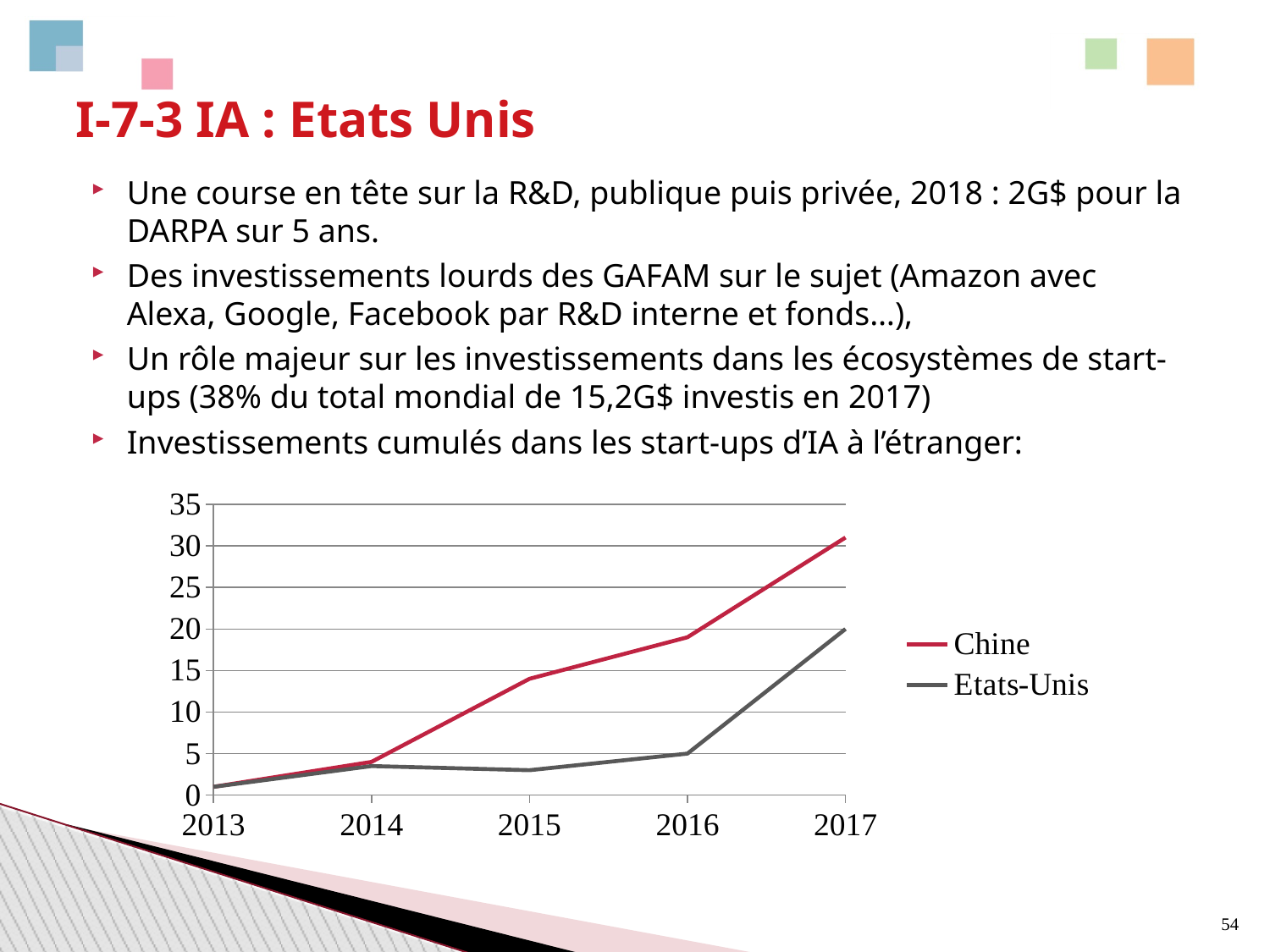
How many series does the legend list? 2 What kind of chart is shown on the slide? line chart What colour is the line for Chine? red In which year does the Chine line reach its highest value? 2017 Which series does the legend list first? Chine Is the value for Chine in 2017 greater or less than 25? greater Is the value for Etats-Unis in 2015 greater or less than 5? less How many years are shown on the x axis of the chart? 5 In 2017, which series has the larger value, Chine or Etats-Unis? Chine Does the Chine line rise or fall from 2013 to 2017? rise In which year is the Etats-Unis line at its lowest value? 2013 Is the value for Chine in 2015 greater or less than 10? greater